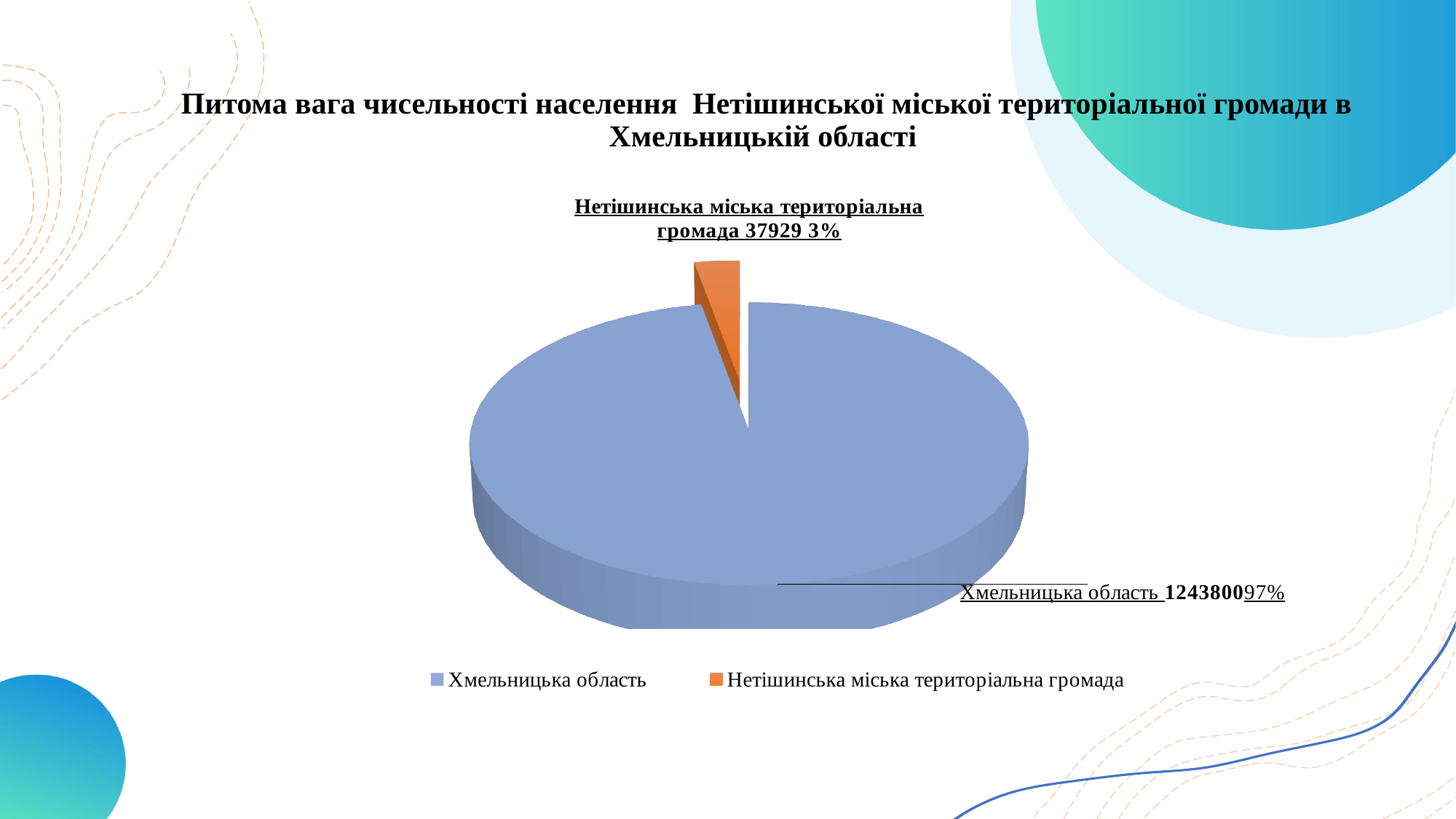
Which slice of the pie is the smallest? Нетішинська міська територіальна громада What is the difference between the value for Хмельницька область and the value for Нетішинська міська територіальна громада? 1205871 How many entries does the legend list? 2 Which is larger, the value for Хмельницька область or the value for Нетішинська міська територіальна громада? Хмельницька область Which slice of the pie is the largest? Хмельницька область What share of the pie does Хмельницька область represent? 97% What value is shown for Нетішинська міська територіальна громада? 37929 What value is shown for Хмельницька область? 1243800 What share of the pie does Нетішинська міська територіальна громада represent? 3% How many slices does the pie chart have? 2 What colour is the slice for Нетішинська міська територіальна громада? orange What kind of chart is shown on the slide? pie chart